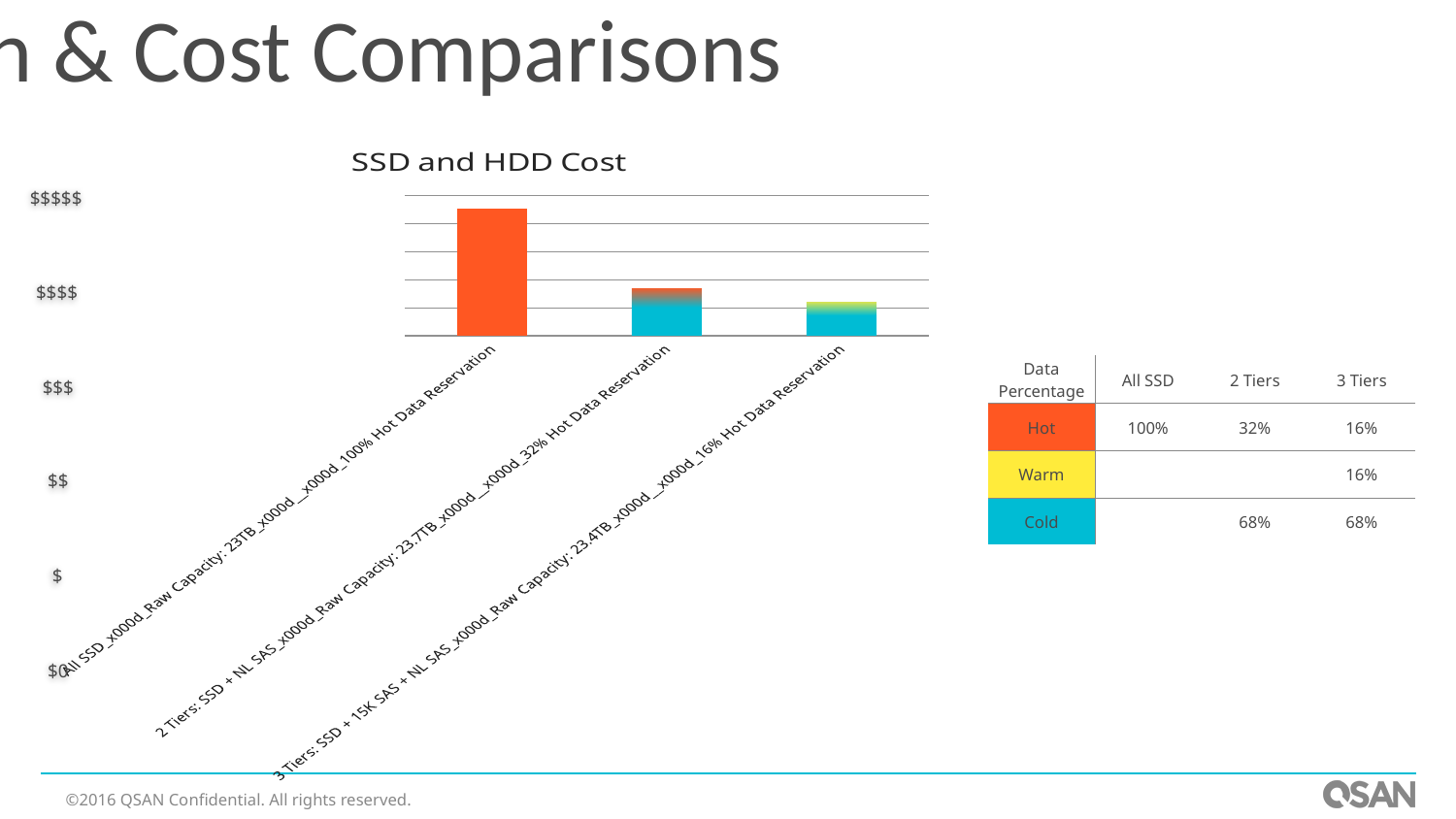
How many categories (bars) are shown in the "SSD and HDD Cost" chart? 3 In the "SSD and HDD Cost" chart, which configuration has the highest total cost bar? All SSD What is the title of the chart on the slide? SSD and HDD Cost In the "SSD and HDD Cost" chart, which bar is taller: 2 Tiers: SSD + NL SAS or 3 Tiers: SSD + 15K SAS + NL SAS? 2 Tiers: SSD + NL SAS In the "SSD and HDD Cost" chart, what colour is the bar for All SSD? orange In the "SSD and HDD Cost" chart, what hot data reservation percentage is stated in the 3 Tiers category label? 16% In the "SSD and HDD Cost" chart, is the bar for All SSD taller or shorter than the bar for 2 Tiers: SSD + NL SAS? taller In the "SSD and HDD Cost" chart, do the bar heights rise or fall from left to right across the categories? fall In the "SSD and HDD Cost" chart, what is the raw capacity stated in the All SSD category label? 23TB What kind of chart is the "SSD and HDD Cost" chart? bar chart In the "SSD and HDD Cost" chart, which configuration has the lowest total cost bar? 3 Tiers: SSD + 15K SAS + NL SAS